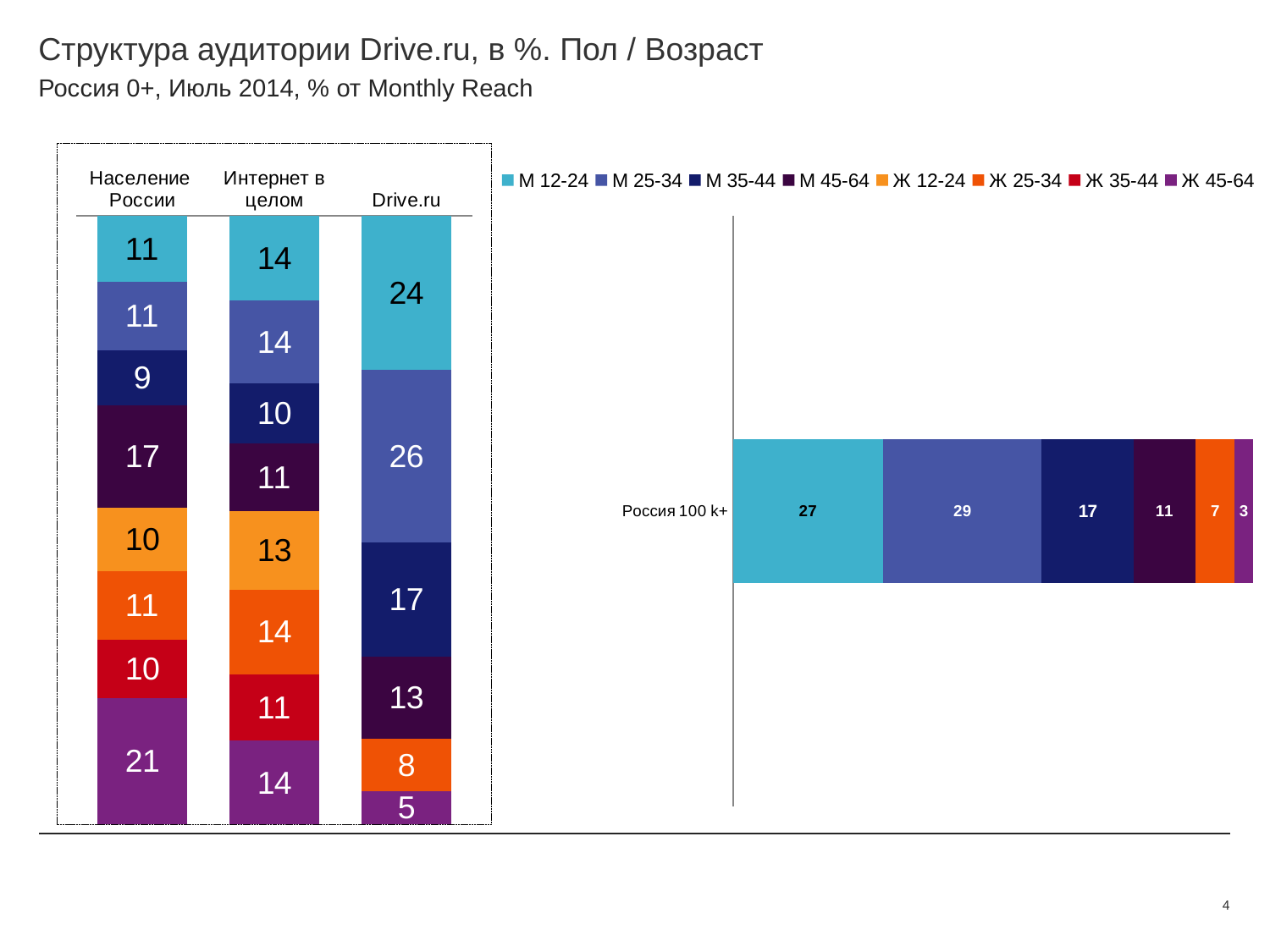
In the left chart, which is larger for М 12-24: Население России or Интернет в целом? Интернет в целом How many bars (categories) does the left chart show? 3 In the left chart, what is the value for Ж 45-64 in the Население России bar? 21 How many series does the legend list? 8 In the left chart, what is the difference between the М 25-34 values for Drive.ru and Население России? 15 In the right chart (Россия 100 k+), which series has the largest segment? М 25-34 In the left chart, which bar has the largest М 12-24 segment? Drive.ru In the right chart (Россия 100 k+), what is the smallest value shown? 3 In the right chart (Россия 100 k+), what is the difference between the М 12-24 and М 35-44 values? 10 In the left chart, what is the value for М 12-24 in the Drive.ru bar? 24 In the left chart, what is the value for М 25-34 in the Drive.ru bar? 26 In the right chart (Россия 100 k+), what is the value for М 25-34? 29